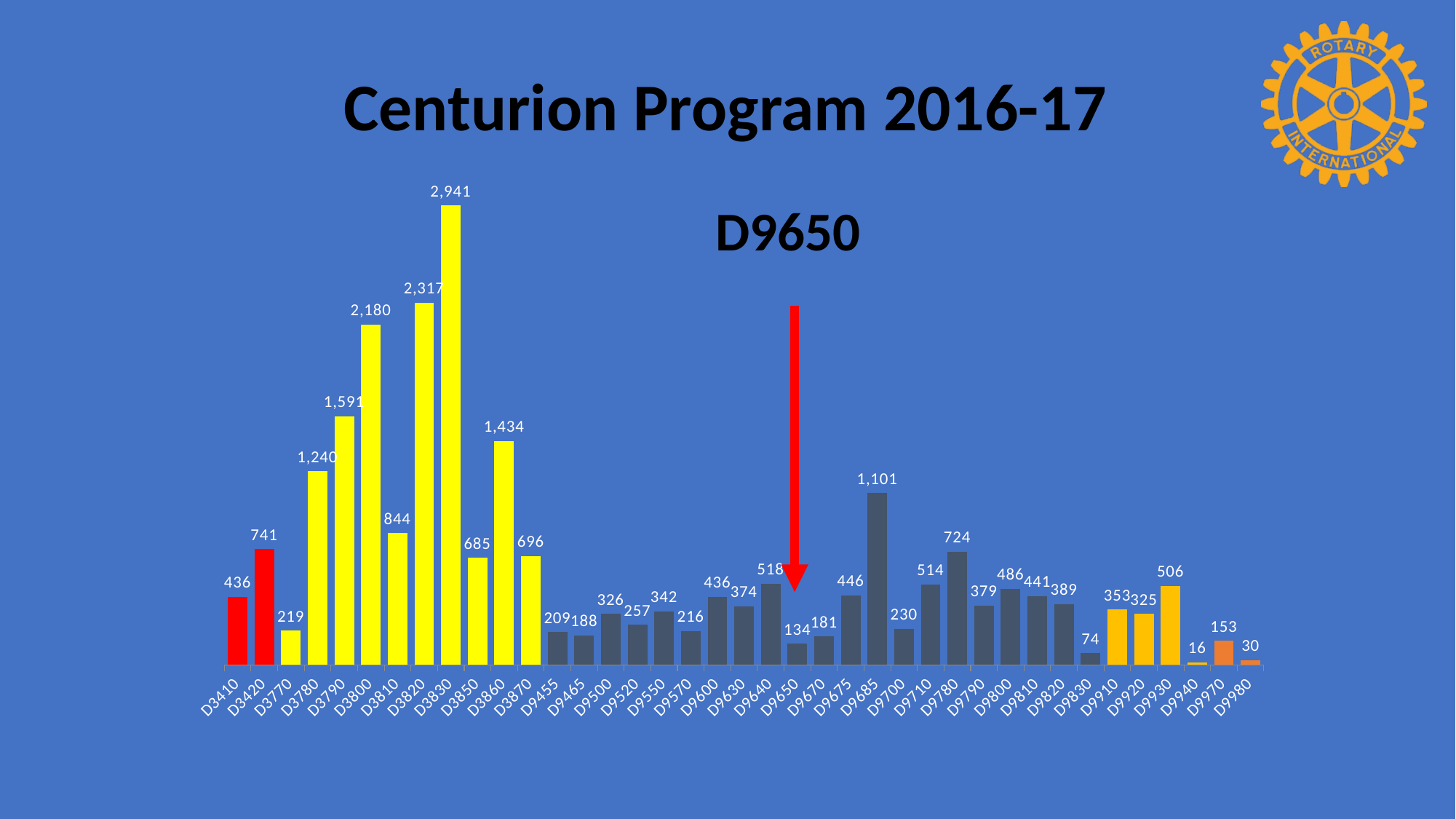
Which district does the red arrow point to? D9650 Which is larger, the value for D9780 or the value for D9710? D9780 What is the title of the slide? Centurion Program 2016-17 Which district has the lowest value? D9940 What is the difference between the values for D9640 and D9650? 384 What is the value for D3830? 2,941 How many districts are shown on the chart? 39 What is the value for D9650? 134 Which district has the highest value? D3830 What is the difference between the values for D3820 and D3800? 137 What kind of chart is shown on the slide? bar chart What is the value for D9685? 1,101